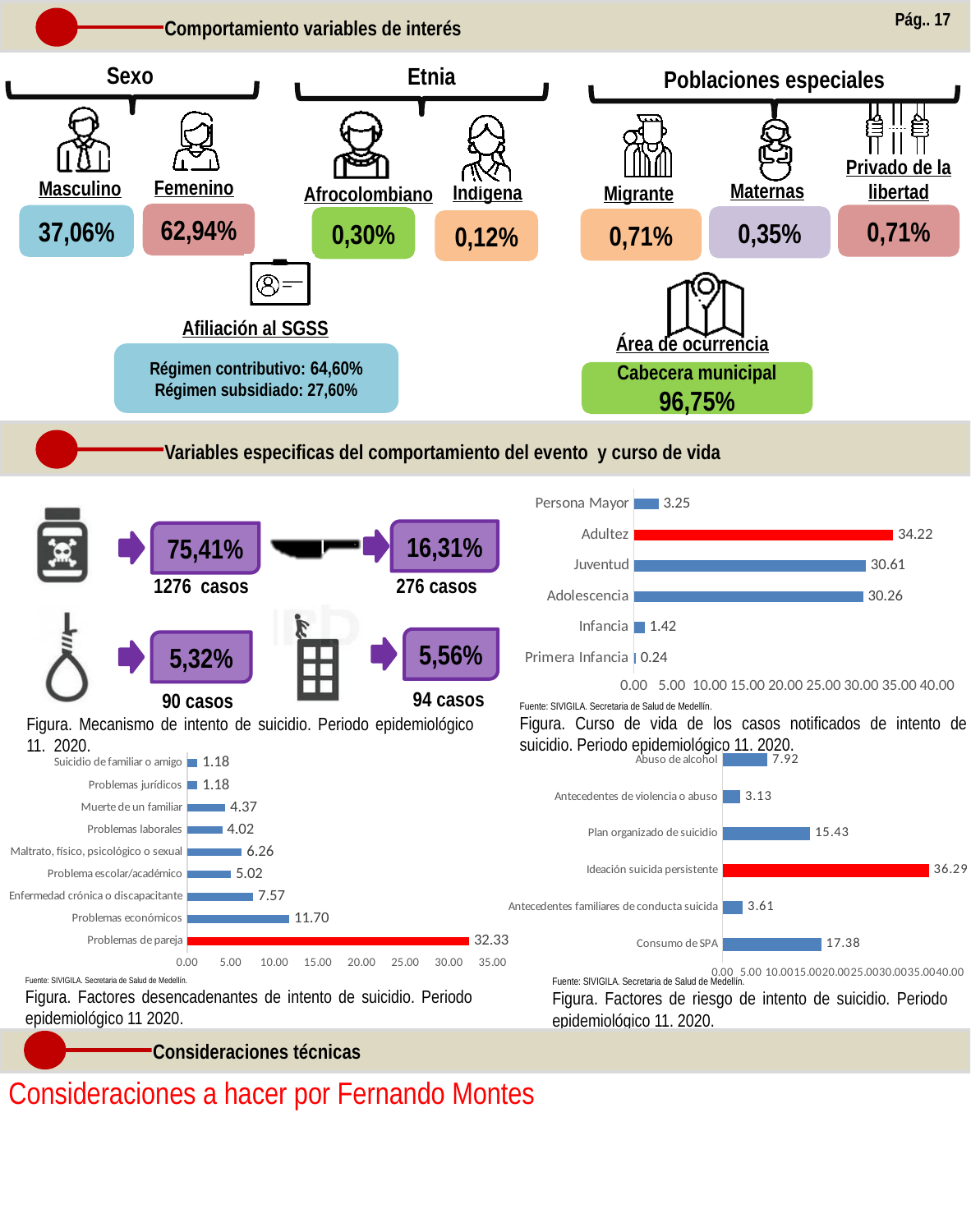
In the 'Factores de riesgo' chart (bottom right), what is the difference between Ideación suicida persistente and Plan organizado de suicidio? 20.86 In the 'Curso de vida' chart (top right), what is the difference between Juventud and Adolescencia? 0.35 In the 'Curso de vida' chart (top right), what is the value for Adultez? 34.22 In the 'Factores de riesgo' chart (bottom right), which category has the lowest value? Antecedentes de violencia o abuso In the 'Factores desencadenantes' chart (bottom left), which category has the highest value? Problemas de pareja In the 'Factores desencadenantes' chart (bottom left), what is the value for Problemas económicos? 11.70 In the 'Curso de vida' chart (top right), how many categories are shown? 6 In the 'Factores desencadenantes' chart (bottom left), how many categories are shown? 9 What type of chart is the 'Factores de riesgo' chart (bottom right)? Bar chart In the 'Factores desencadenantes' chart (bottom left), which is larger: Muerte de un familiar or Problemas laborales? Muerte de un familiar In the 'Factores de riesgo' chart (bottom right), what is the value for Consumo de SPA? 17.38 In the 'Curso de vida' chart (top right), which category has the lowest value? Primera Infancia